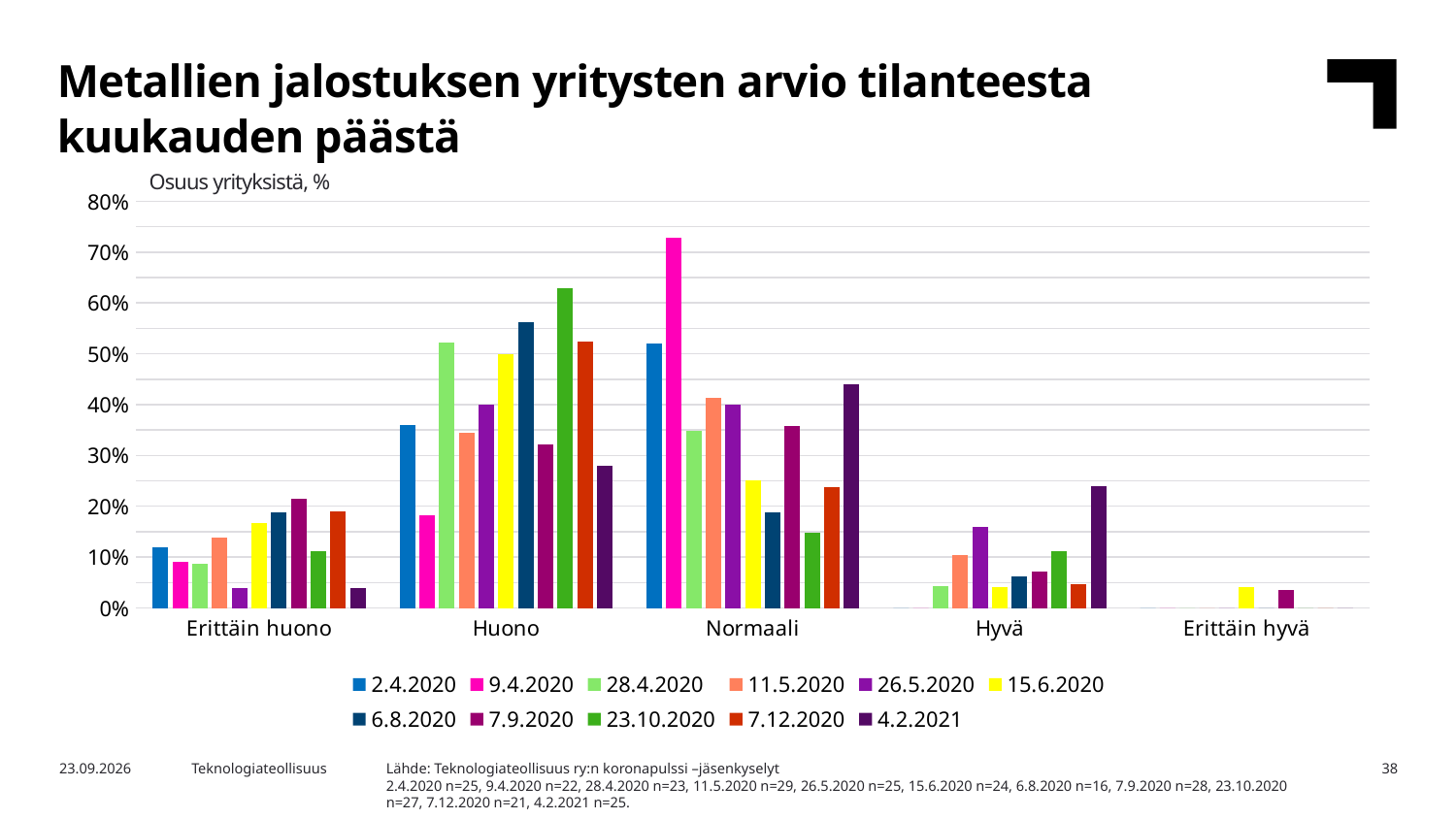
What is the label shown above the y axis of the chart? Osuus yrityksistä, % Is the value for 9.4.2020 in the Normaali category greater or less than 70%? greater How many categories are shown on the x axis of the chart? 5 Which category contains the tallest bar in the chart? Normaali Is the value for 4.2.2021 in the Hyvä category greater or less than 20%? greater How many series does the legend list? 11 What kind of chart is shown on the slide? bar chart In the Normaali category, which is larger: the value for 2.4.2020 or for 9.4.2020? 9.4.2020 In the Huono category, which is larger: the value for 28.4.2020 or for 9.4.2020? 28.4.2020 Is the value for 6.8.2020 in the Huono category greater or less than 50%? greater In the Hyvä category, which series has the highest value? 4.2.2021